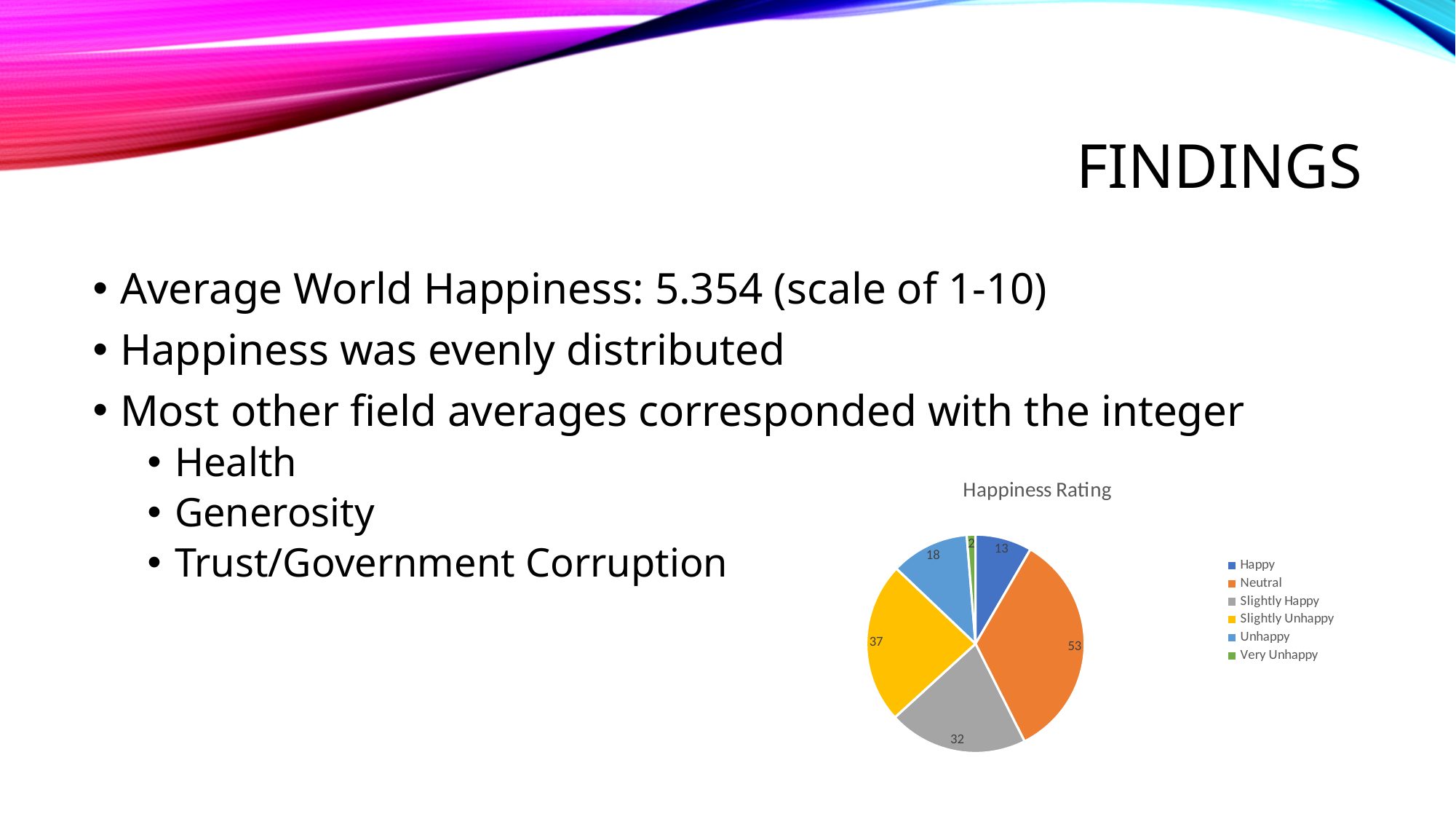
What is the value for the Slightly Unhappy slice in the Happiness Rating chart? 37 What is the difference between the Neutral and Slightly Happy values in the Happiness Rating chart? 21 Which category has the smallest slice in the Happiness Rating chart? Very Unhappy What is the value for the Neutral slice in the Happiness Rating chart? 53 What is the title of the chart? Happiness Rating What is the total of all slices in the Happiness Rating chart? 155 What type of chart is shown on the slide? Pie chart How many categories does the legend of the Happiness Rating chart list? 6 What is the value for the Very Unhappy slice in the Happiness Rating chart? 2 What is the value for the Happy slice in the Happiness Rating chart? 13 Which category has the largest slice in the Happiness Rating chart? Neutral Which is larger in the Happiness Rating chart, Slightly Unhappy or Unhappy? Slightly Unhappy